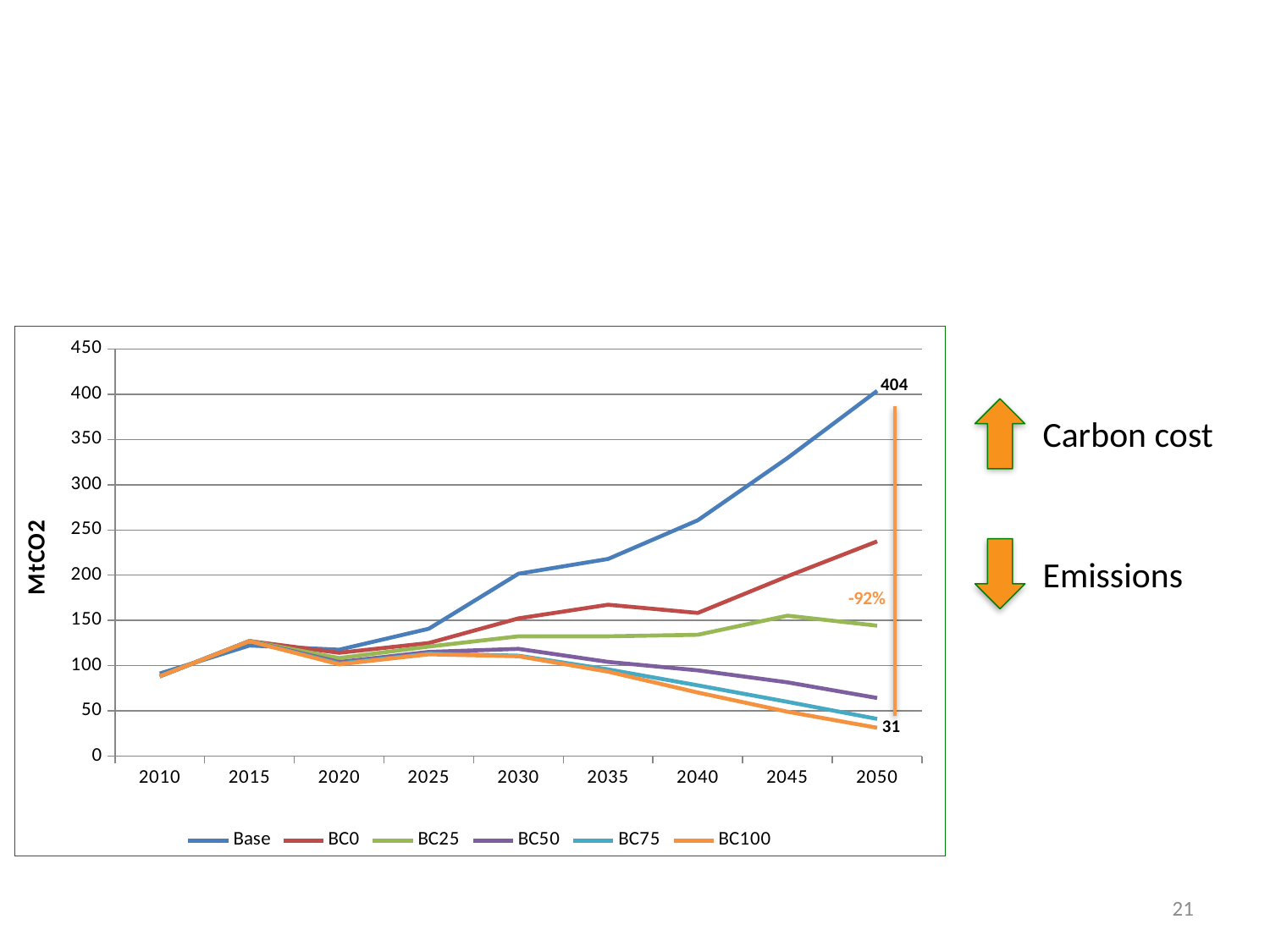
What is the label on the y axis? MtCO2 What is the value of the Base series in 2050? 404 Is the value for BC0 in 2050 greater or less than 200? greater Which series has the highest value in 2050? Base Which series has the lowest value in 2050? BC100 In 2050, which series has the larger value, BC0 or BC25? BC0 What kind of chart is shown on the slide? Line chart Does the Base series rise or fall from 2010 to 2050? Rise How many series does the legend list? 6 What is the difference between the Base and BC100 values in 2050? 373 What is the value of the BC100 series in 2050? 31 How many years are shown on the x axis? 9